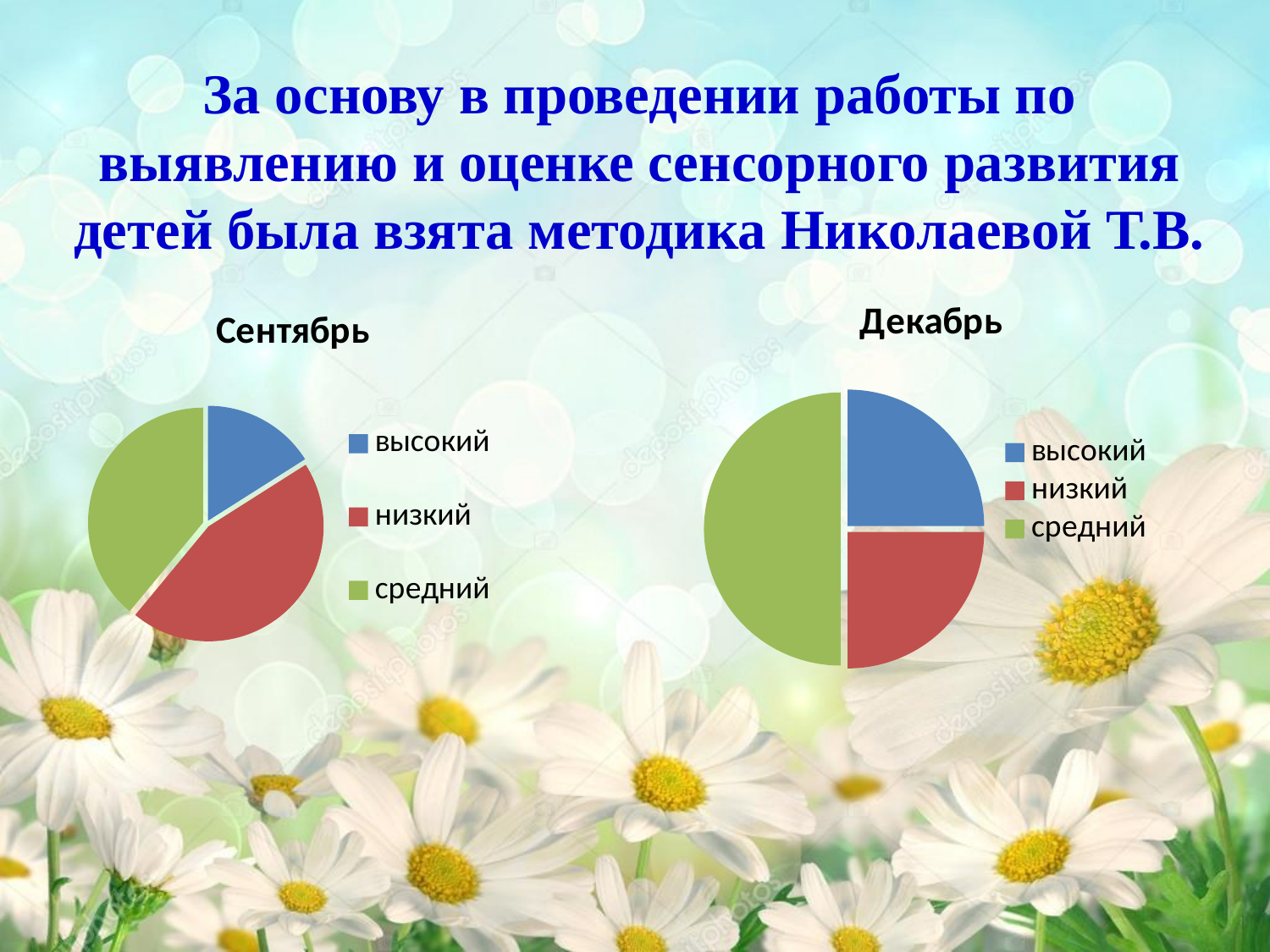
What colour represents "низкий" in the "Декабрь" chart? red How many slices does the "Сентябрь" pie chart have? 3 In the "Сентябрь" chart, which slice is larger: "средний" or "высокий"? средний In the "Сентябрь" chart, which slice is larger: "высокий" or "низкий"? низкий In the "Сентябрь" chart, which category has the smallest slice? высокий What kind of chart is the chart titled "Сентябрь"? pie chart What is the title of the pie chart on the left side of the slide? Сентябрь In the "Декабрь" chart, which slice is larger: "средний" or "высокий"? средний In the "Декабрь" chart, which category has the largest slice? средний What kind of chart is the chart titled "Декабрь"? pie chart How many entries does the legend of the "Декабрь" chart list? 3